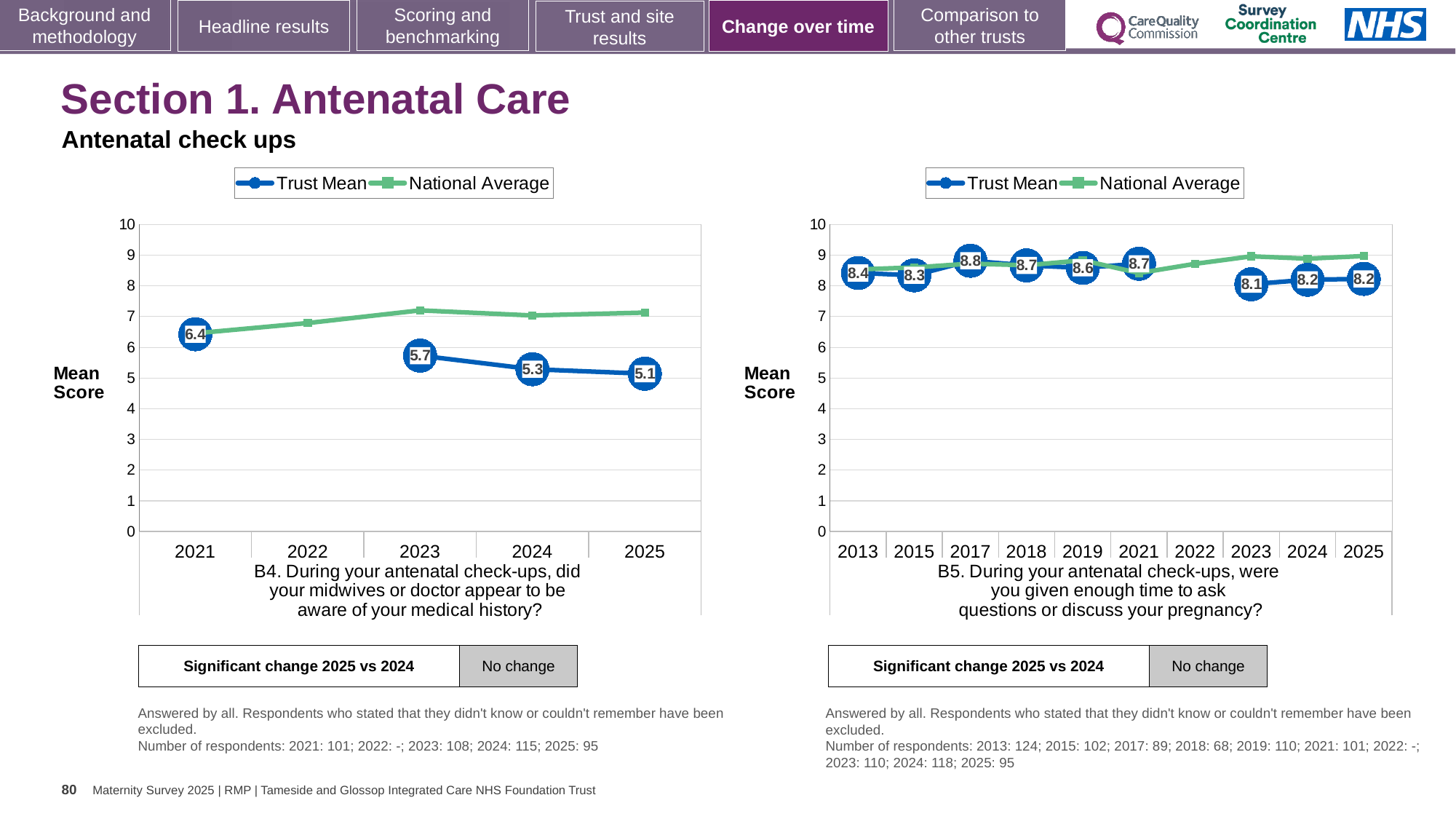
In the B4 chart on the left, what is the Trust Mean for 2021? 6.4 How many years are shown on the x axis of the B5 chart on the right? 10 What kind of chart is the B4 chart on the left? Line chart In the B5 chart on the right, which year has the highest Trust Mean? 2017 In the B4 chart on the left, what is the difference between the Trust Mean in 2021 and in 2025? 1.3 How many series does the legend of the B4 chart on the left list? 2 In the B4 chart on the left, is the National Average for 2023 greater or less than 7? greater In the B5 chart on the right, what is the Trust Mean for 2023? 8.1 In the B5 chart on the right, which is larger, the Trust Mean for 2019 or for 2023? 2019 In the B5 chart on the right, what is the Trust Mean for 2017? 8.8 In the B4 chart on the left, what is the Trust Mean for 2025? 5.1 In the B4 chart on the left, which year has the lowest Trust Mean? 2025